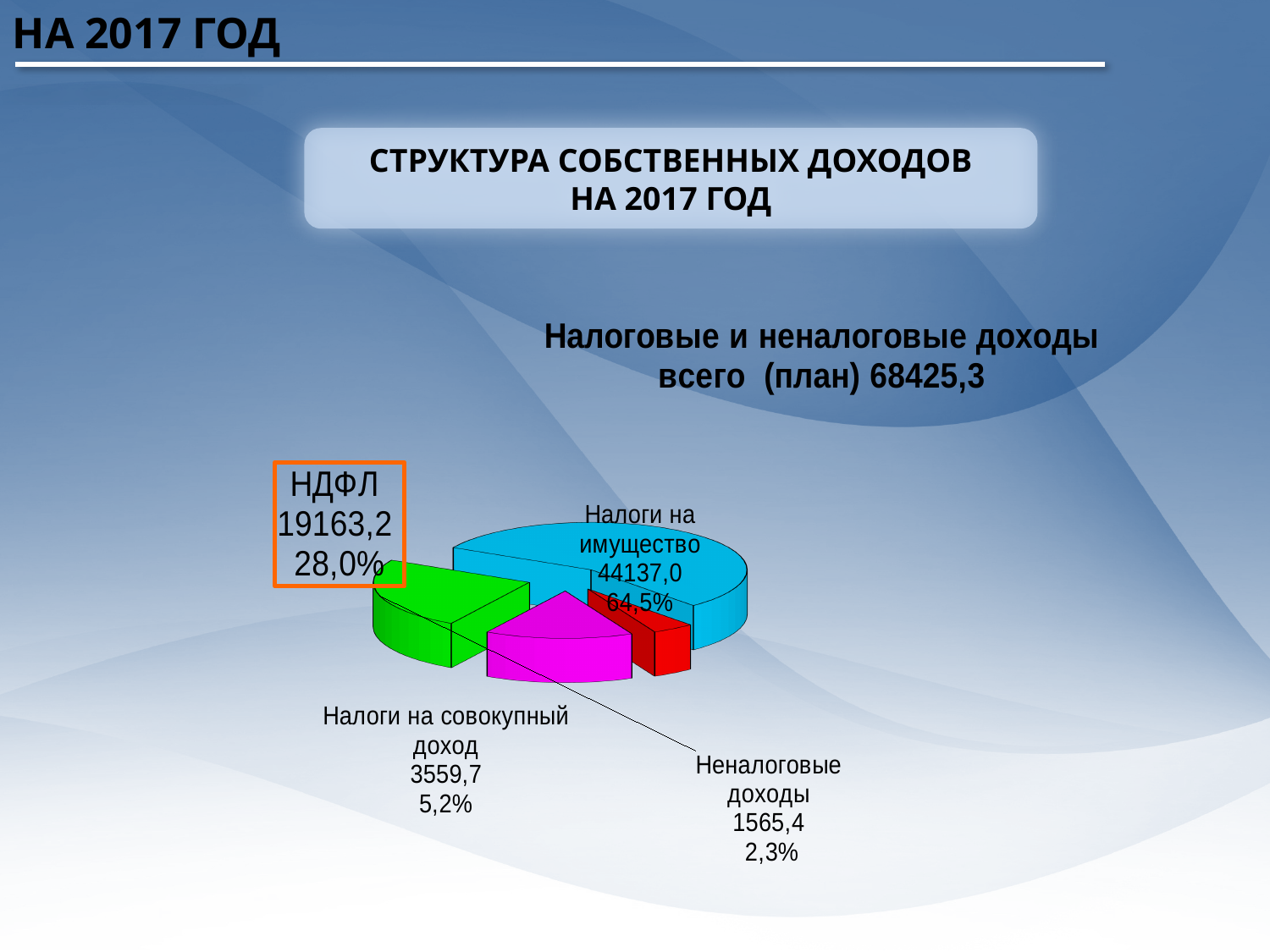
What share of the pie does НДФЛ represent? 28,0% How many slices does the pie chart have? 4 Which category has the largest slice of the pie? Налоги на имущество What is the value shown for НДФЛ? 19163,2 What kind of chart is shown on the slide? Pie chart What is the value shown for Налоги на совокупный доход? 3559,7 What is the value shown for Налоги на имущество? 44137,0 Which is larger, the value for НДФЛ or the value for Налоги на совокупный доход? НДФЛ What share of the pie does Неналоговые доходы represent? 2,3% What total value is stated in the chart title (всего (план))? 68425,3 What share of the pie does Налоги на имущество represent? 64,5%